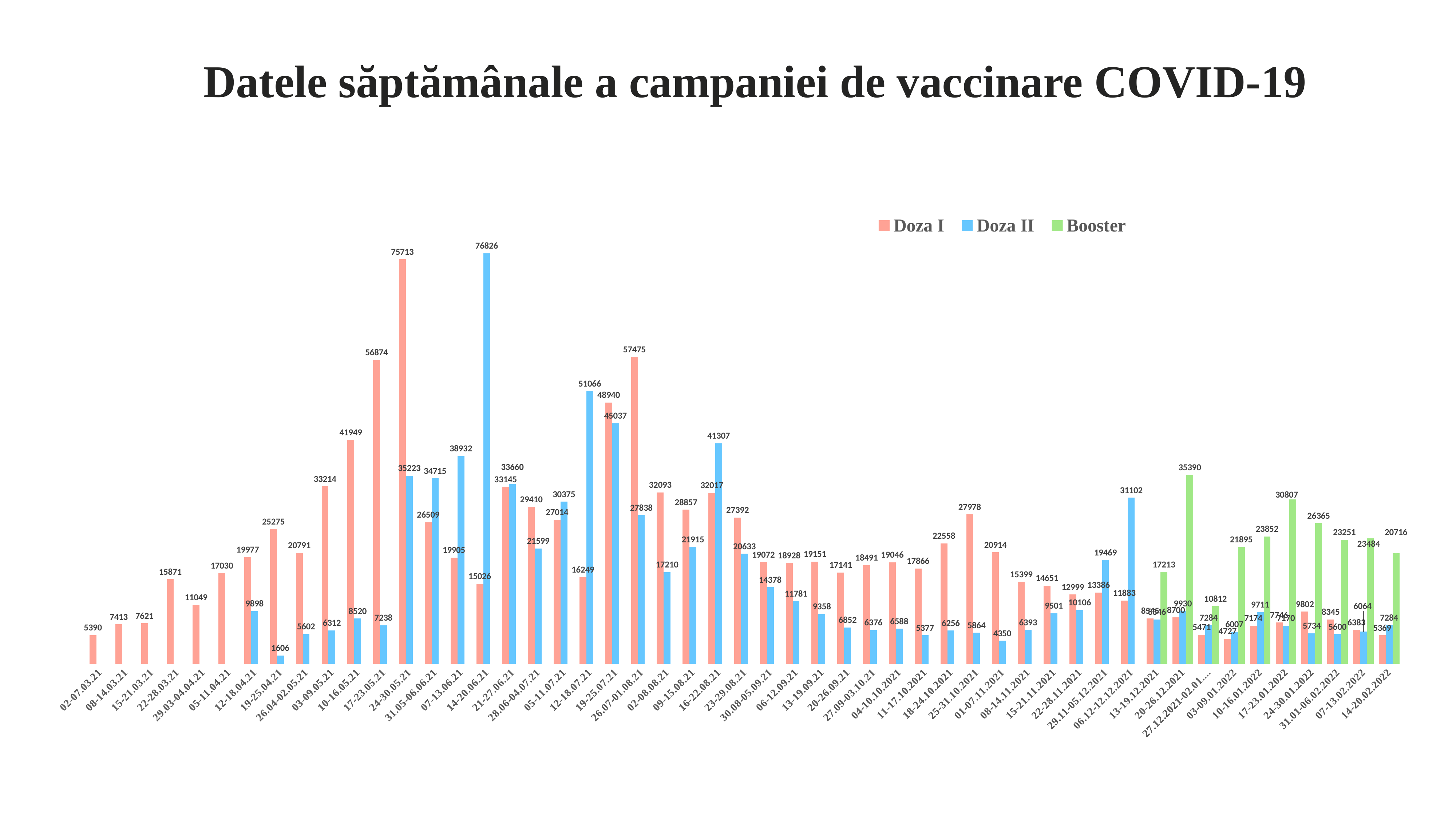
In which week is the Booster value highest? 20-26.12.2021 What is the Doza I value for the week 24-30.05.21? 75713 In the week 12-18.07.21, which is larger: Doza I or Doza II? Doza II What are the three series named in the legend? Doza I, Doza II, Booster What is the difference between Doza I and Doza II in the week 19-25.07.21? 3903 What kind of chart is shown on the slide? bar chart What is the Booster value for the week 17-23.01.2022? 30807 What is the Doza I value for the week 17-23.05.21? 56874 How many series does the legend list? 3 Do the Booster values rise or fall from 03-09.01.2022 to 17-23.01.2022? rise What is the Doza II value for the week 14-20.06.21? 76826 In which week is the Doza II value lowest? 19-25.04.21